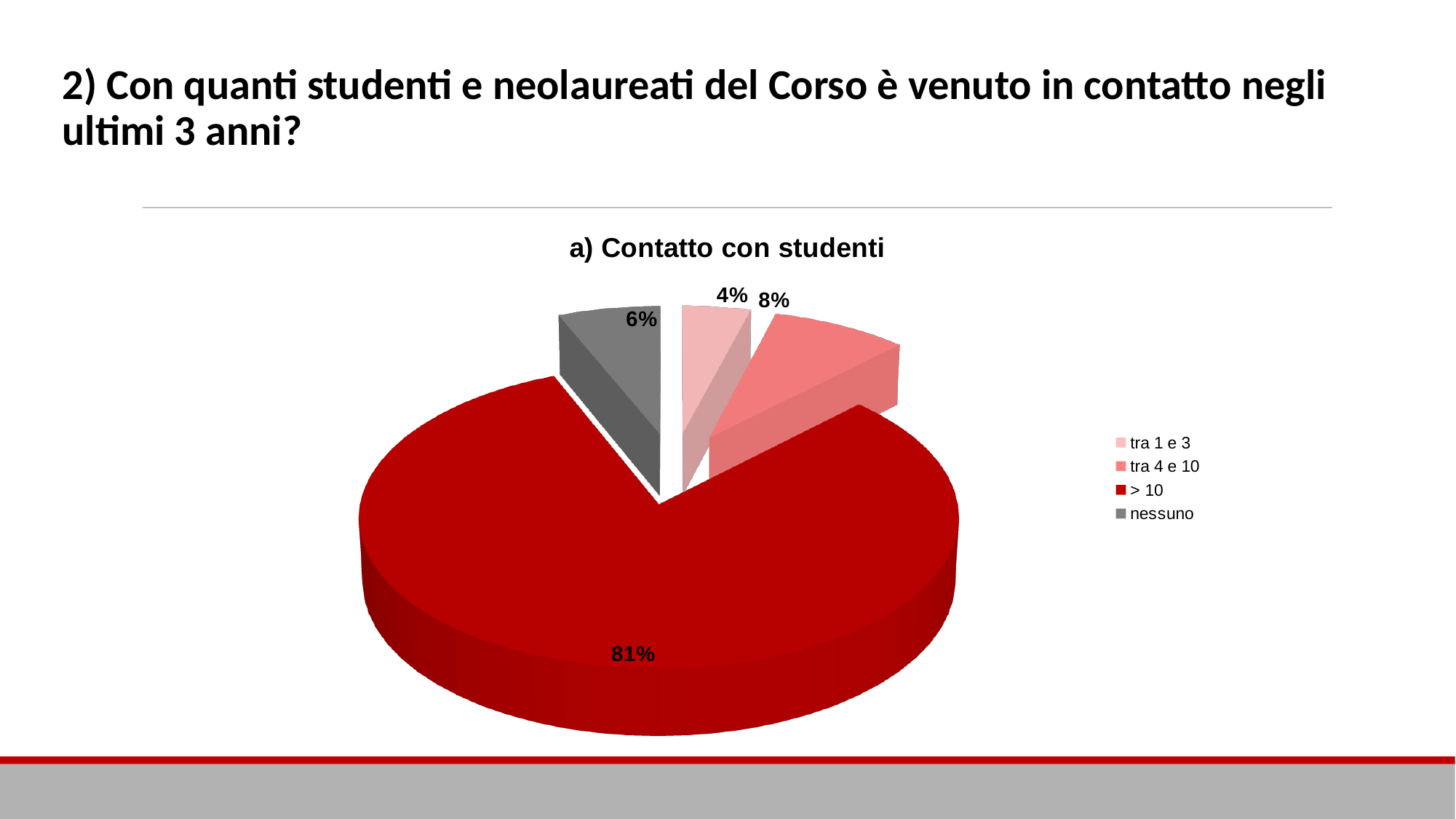
Which is larger, the 'tra 4 e 10' slice or the 'nessuno' slice? tra 4 e 10 What share of the pie is the 'tra 1 e 3' slice? 4% What kind of chart is shown on the slide? pie chart Which category has the largest slice? > 10 What share of the pie is the 'nessuno' slice? 6% What is the difference in percentage points between the '> 10' slice and the 'tra 4 e 10' slice? 73 How many slices does the pie chart have? 4 What is the title of the chart? a) Contatto con studenti What share of the pie is the 'tra 4 e 10' slice? 8% Which category has the smallest slice? tra 1 e 3 How many entries does the legend list? 4